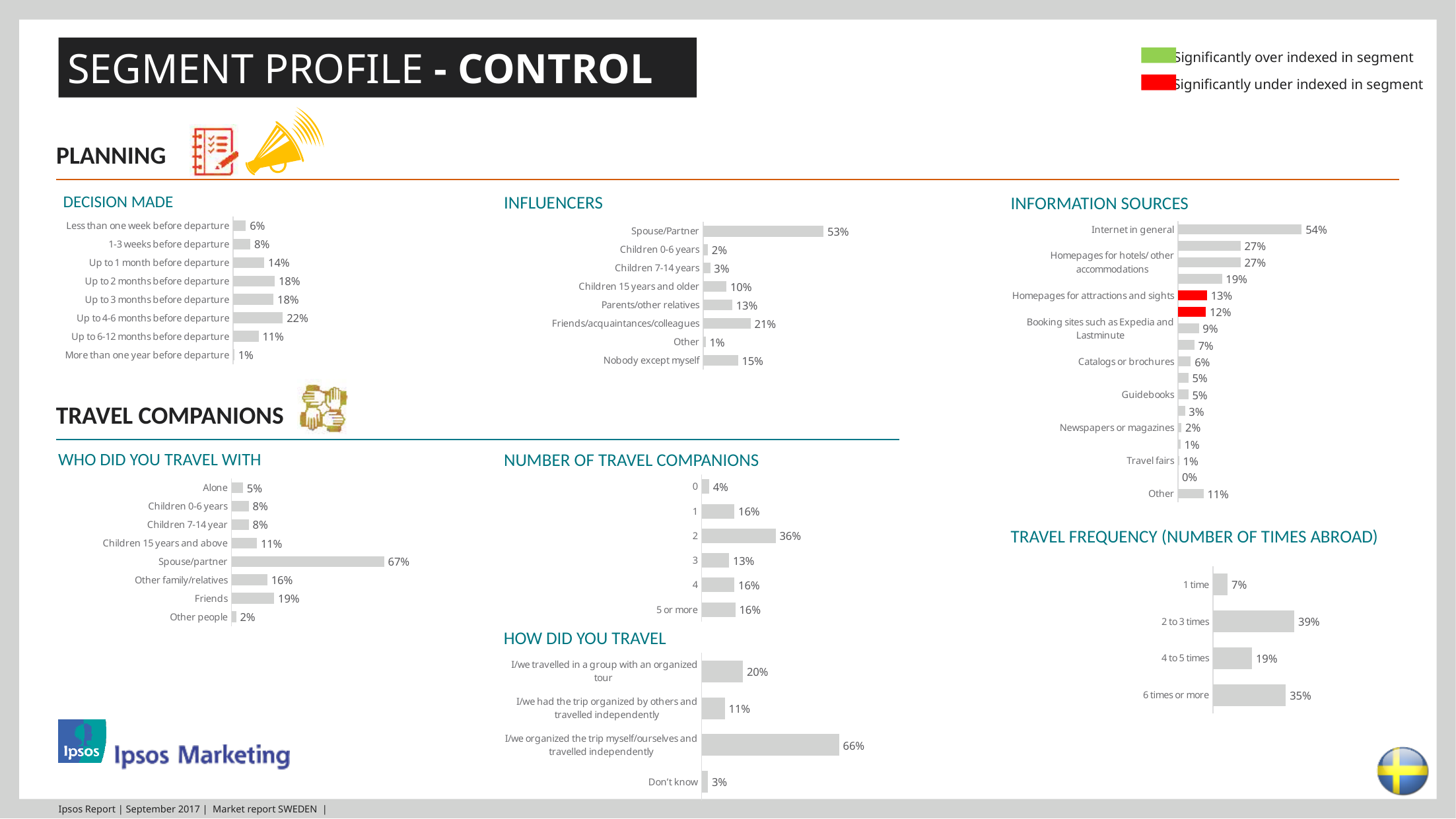
In the 'Number of travel companions' chart, what is the value for '2'? 36% In the 'Who did you travel with' chart, which category has the highest value? Spouse/partner In the 'Decision made' chart, what is the value for 'Up to 4-6 months before departure'? 22% In the 'Who did you travel with' chart, which is larger: 'Friends' or 'Other family/relatives'? Friends In the 'Travel frequency (number of times abroad)' chart, what is the difference between '2 to 3 times' and '6 times or more'? 4% In the 'Influencers' chart, what is the value for 'Spouse/Partner'? 53% In the 'Decision made' chart, which category has the lowest value? More than one year before departure In the 'Influencers' chart, how many categories are shown? 8 In the 'Influencers' chart, what is the difference between 'Friends/acquaintances/colleagues' and 'Nobody except myself'? 6% In the 'Information sources' chart, what is the value for 'Internet in general'? 54% What type of chart is the 'Travel frequency (number of times abroad)' chart? Bar chart In the 'How did you travel' chart, what is the value for 'I/we organized the trip myself/ourselves and travelled independently'? 66%